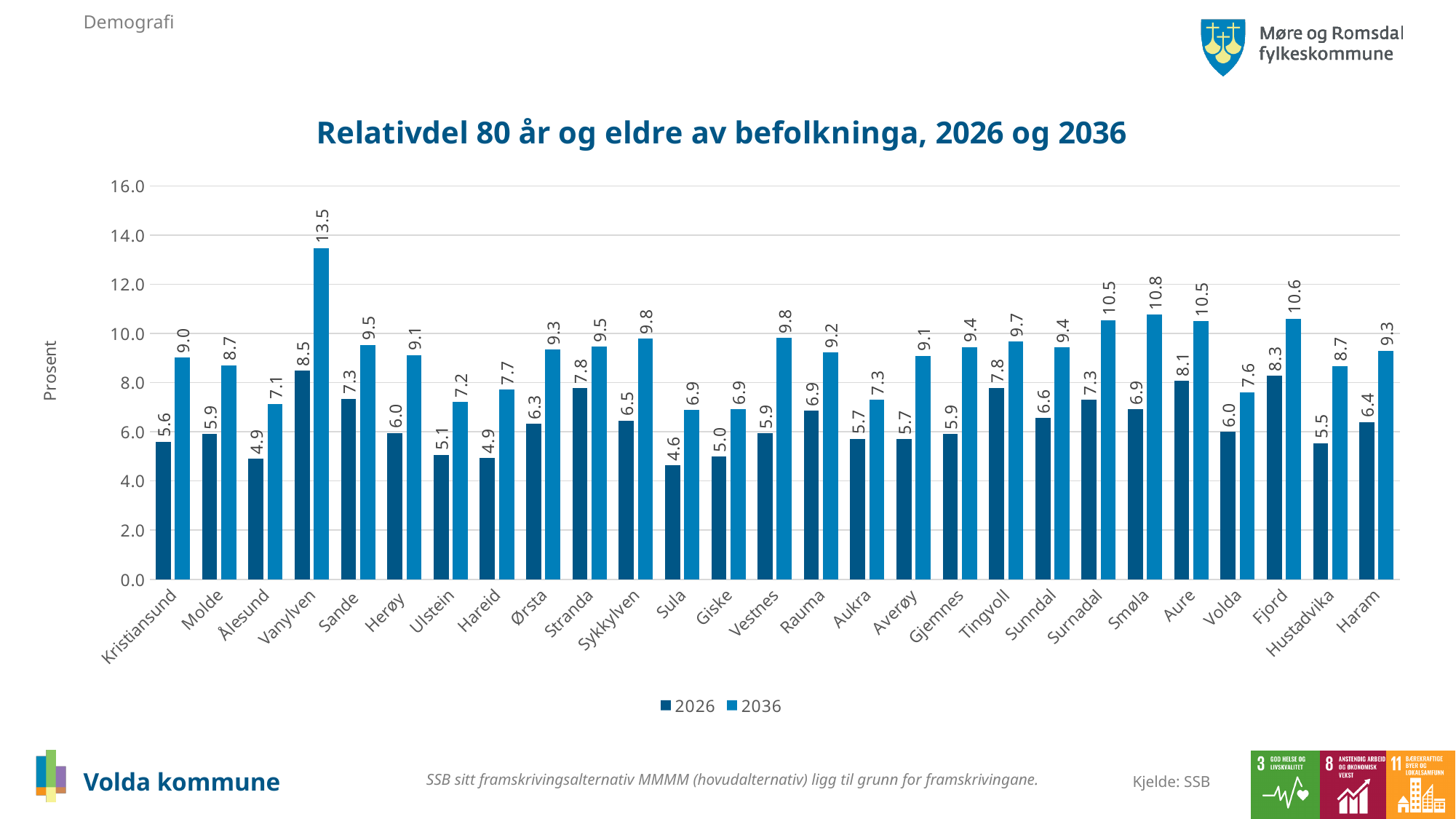
What is the value for Smøla in 2036? 10.8 How many series does the legend list? 2 Is the 2036 value for Surnadal greater or less than 10.0? greater What is the value for Volda in 2026? 6.0 How many municipalities are shown on the x axis? 27 What kind of chart is shown on the slide? Bar chart Which municipality has the lowest value for 2026? Sula What is the difference between the 2036 and 2026 values for Volda? 1.6 What is the difference between the 2036 values for Vanylven and Fjord? 2.9 Which is larger: the 2026 value for Fjord or the 2026 value for Aure? Fjord Which municipality has the highest value for 2036? Vanylven What is the value for Vanylven in 2036? 13.5